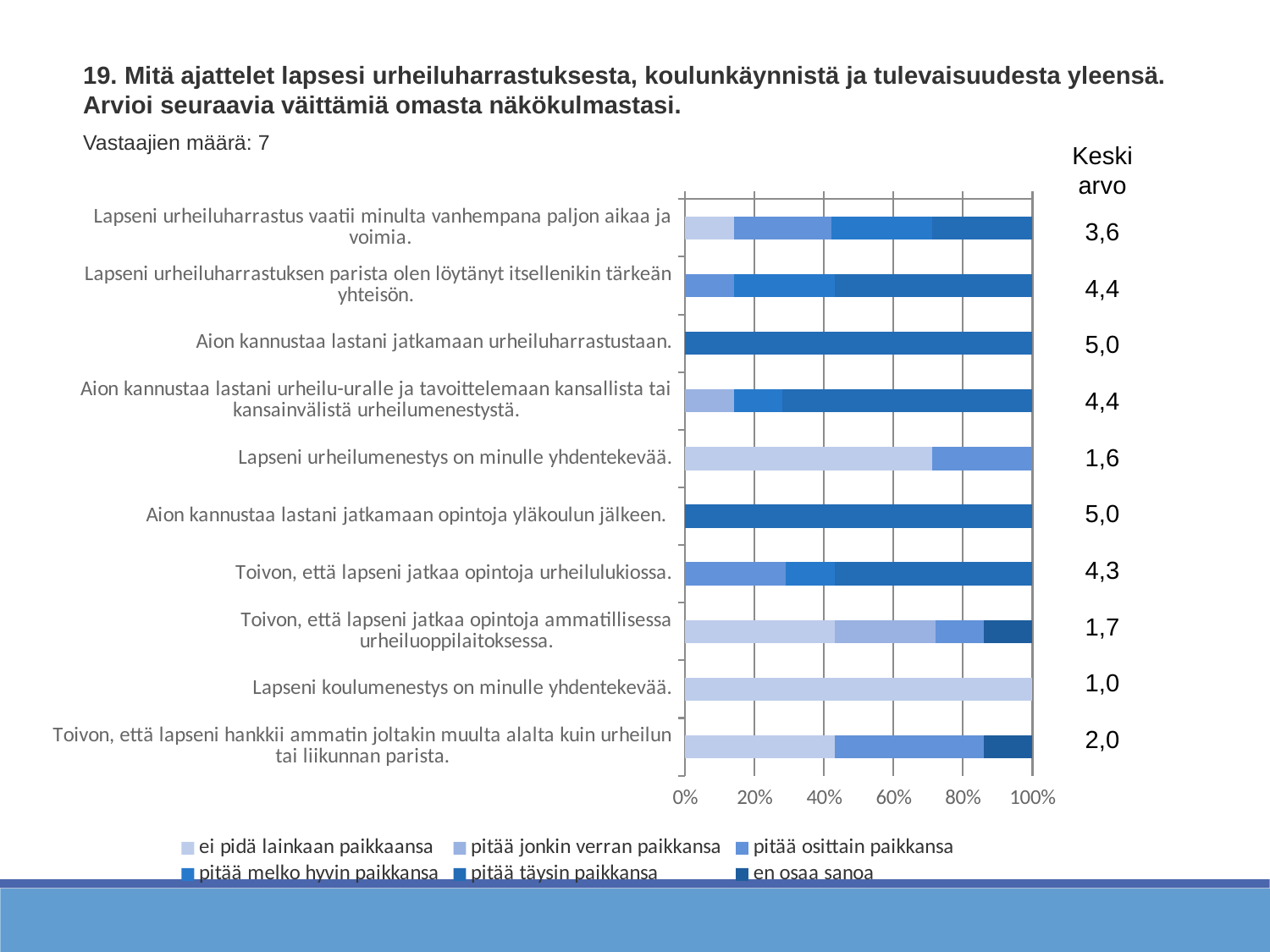
How many series does the chart legend list? 6 How many statements (categories) are plotted in the chart? 10 How many respondents (Vastaajien määrä) does the slide report? 7 What is the Keski arvo (mean) for "Toivon, että lapseni jatkaa opintoja urheilulukiossa."? 4,3 What is the Keski arvo (mean) for "Lapseni urheiluharrastus vaatii minulta vanhempana paljon aikaa ja voimia."? 3,6 Which has the larger Keski arvo: "Toivon, että lapseni jatkaa opintoja urheilulukiossa." or "Toivon, että lapseni jatkaa opintoja ammatillisessa urheiluoppilaitoksessa."? Toivon, että lapseni jatkaa opintoja urheilulukiossa. What is the difference between the Keski arvo for "Lapseni urheiluharrastuksen parista olen löytänyt itsellenikin tärkeän yhteisön." and for "Lapseni urheilumenestys on minulle yhdentekevää."? 2,8 What kind of chart is shown on the slide? Stacked bar chart What is the Keski arvo (mean) for "Lapseni urheilumenestys on minulle yhdentekevää."? 1,6 What is the highest Keski arvo (mean) shown on the slide? 5,0 Which statement has the lowest Keski arvo (mean)? Lapseni koulumenestys on minulle yhdentekevää. Is the "ei pidä lainkaan paikkaansa" share for "Lapseni urheilumenestys on minulle yhdentekevää." greater or less than 60%? greater